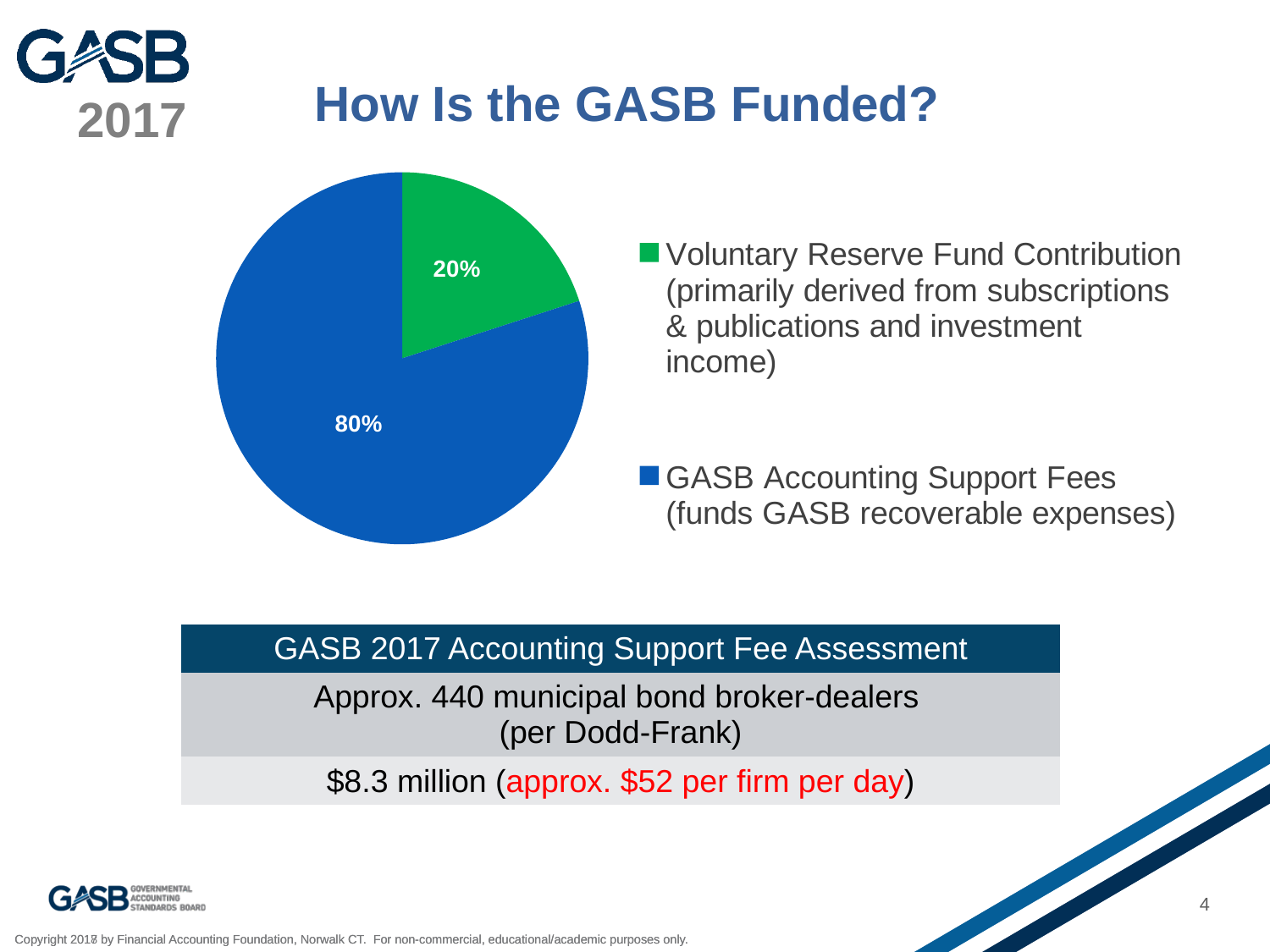
How many slices does the pie chart have? 2 How many entries does the legend list? 2 What colour is the slice for GASB Accounting Support Fees? blue What share of GASB funding comes from GASB Accounting Support Fees? 80% Which funding source makes up the largest slice of the pie? GASB Accounting Support Fees What kind of chart is shown on the slide? pie chart What share of GASB funding comes from the Voluntary Reserve Fund Contribution? 20% Which funding source makes up the smallest slice of the pie? Voluntary Reserve Fund Contribution What colour is the slice for the Voluntary Reserve Fund Contribution? green Which is larger: the Voluntary Reserve Fund Contribution slice or the GASB Accounting Support Fees slice? GASB Accounting Support Fees What is the difference in percentage points between the GASB Accounting Support Fees slice and the Voluntary Reserve Fund Contribution slice? 60 percentage points